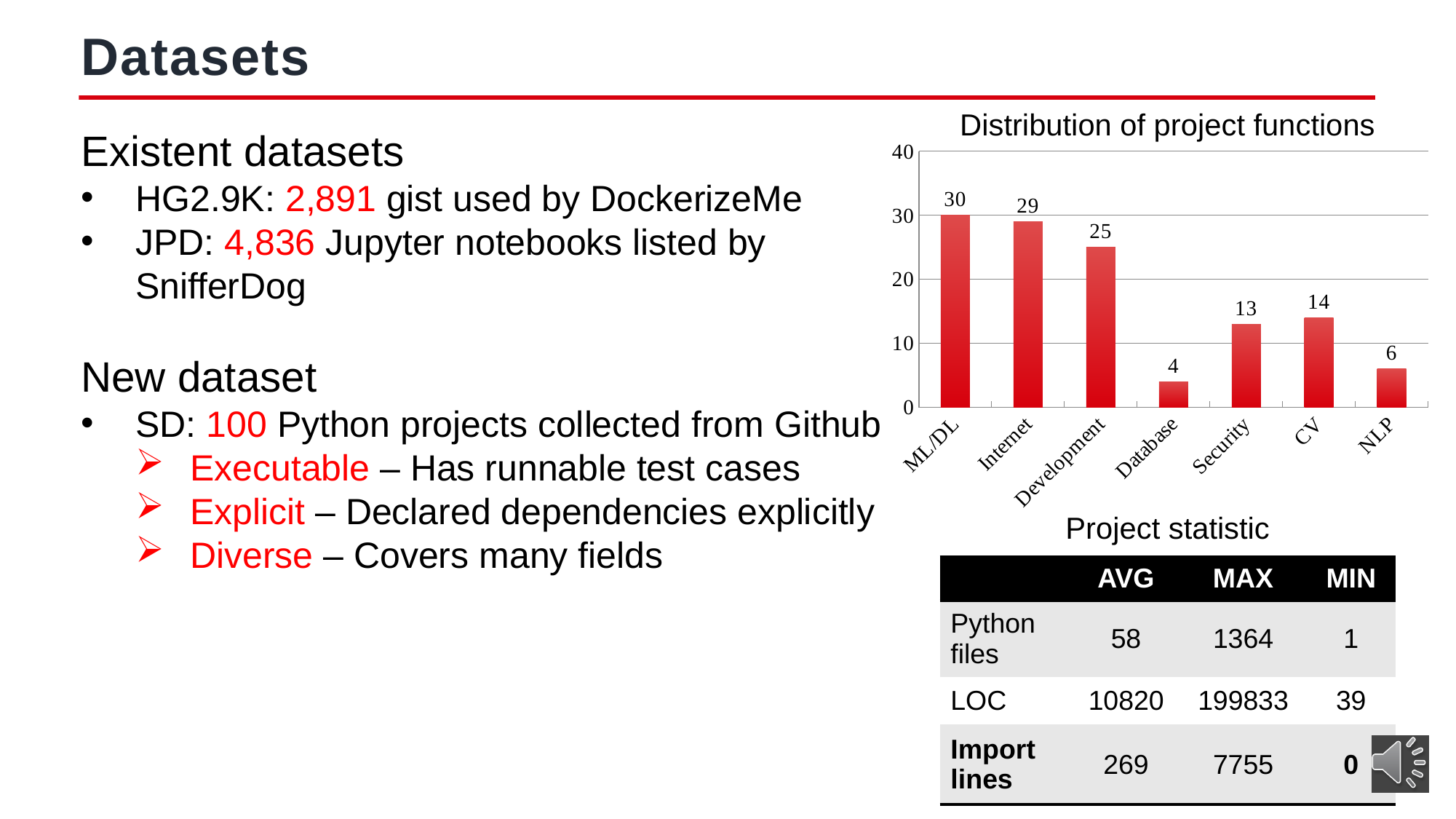
What colour are the bars in the Distribution of project functions chart? red What kind of chart is the Distribution of project functions chart? bar chart What is the value for Database in the Distribution of project functions chart? 4 What is the title of the chart on the slide? Distribution of project functions Which category has the lowest value in the Distribution of project functions chart? Database What is the difference between the values for Internet and Development in the Distribution of project functions chart? 4 What is the value for Security in the Distribution of project functions chart? 13 How many categories are shown in the Distribution of project functions chart? 7 Which category has the highest value in the Distribution of project functions chart? ML/DL Is the value for Development greater or less than 20 in the Distribution of project functions chart? greater Which is larger in the Distribution of project functions chart, CV or NLP? CV What is the value for ML/DL in the Distribution of project functions chart? 30